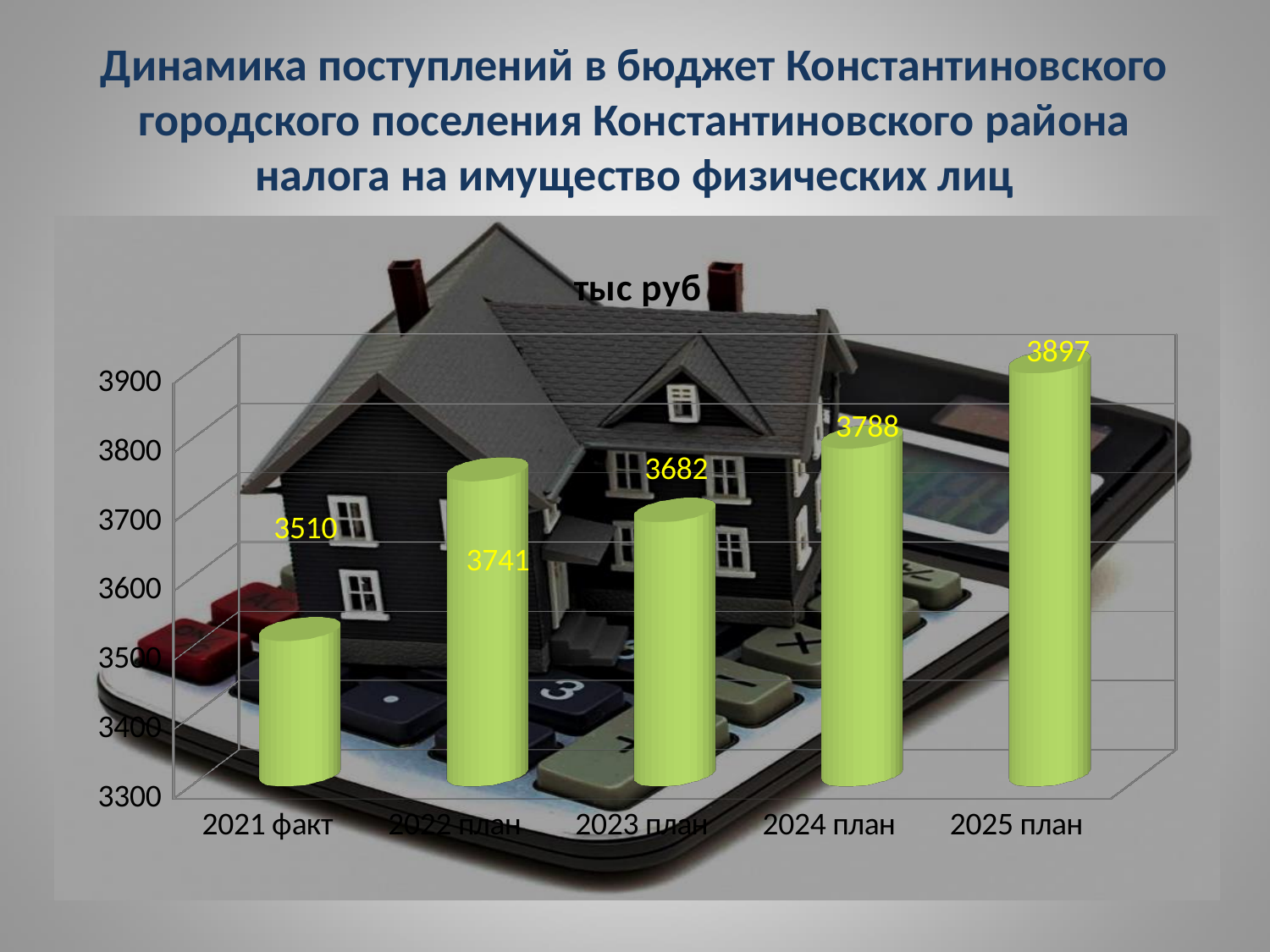
How many categories are shown on the x axis? 5 Which category has the highest value? 2025 план What is the value for 2025 план? 3897 What is the difference between the values for 2025 план and 2021 факт? 387 What is the difference between the values for 2024 план and 2023 план? 106 What is the value for 2021 факт? 3510 What kind of chart is shown on the slide? bar chart What is the value for 2023 план? 3682 Is the value for 2024 план greater or less than 3700? greater Which category has the lowest value? 2021 факт Which is larger, the value for 2022 план or the value for 2023 план? 2022 план What unit is given in the chart title above the bars? тыс руб